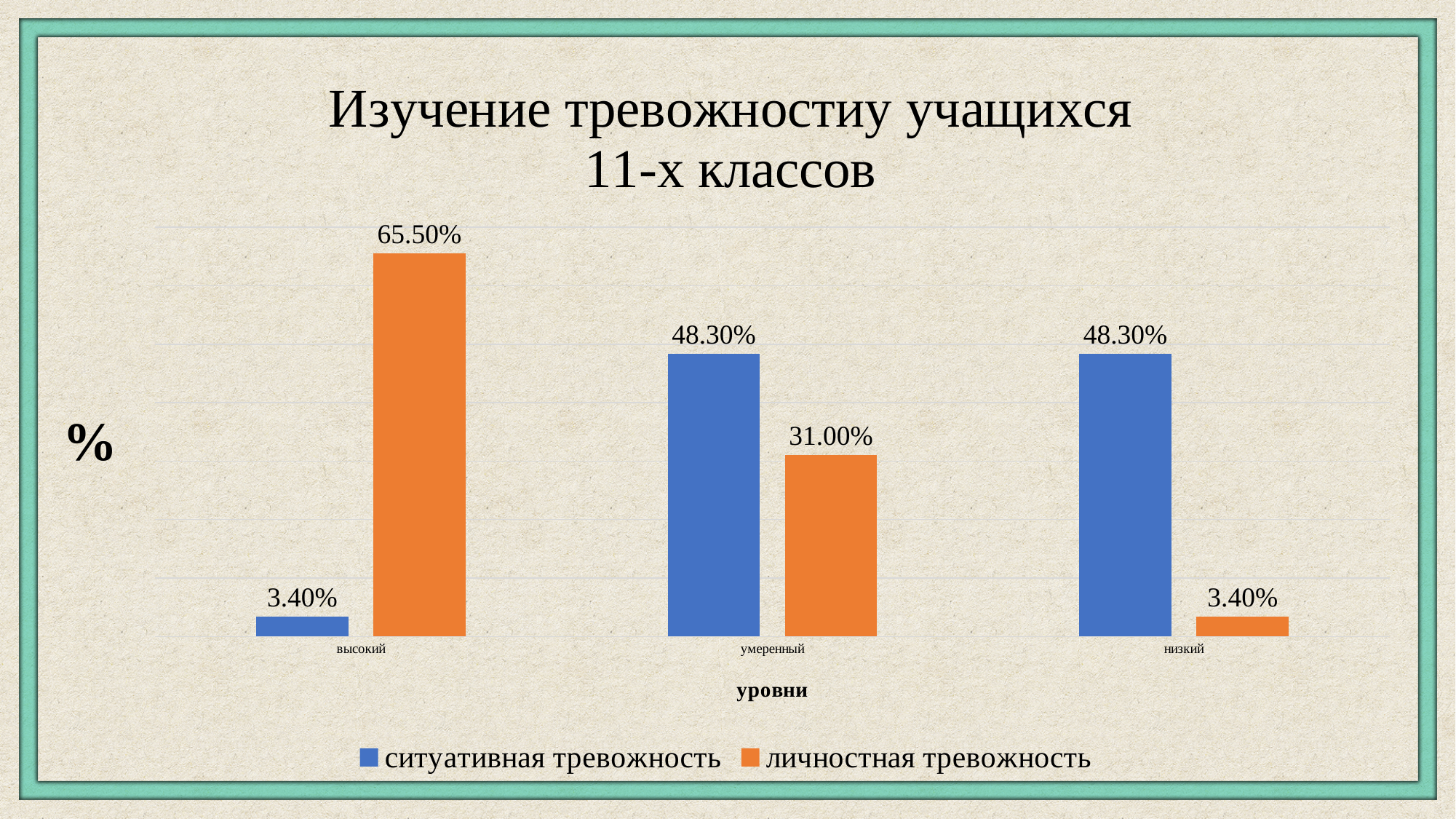
What is the value for ситуативная тревожность at the высокий level? 3.40% What is the value for личностная тревожность at the умеренный level? 31.00% What kind of chart is shown on the slide? bar chart At the умеренный level, which is larger: ситуативная тревожность or личностная тревожность? ситуативная тревожность What is the difference between личностная тревожность and ситуативная тревожность at the высокий level? 62.10% At which level is личностная тревожность lowest? низкий How many levels (categories) are shown on the x axis? 3 What is the value for личностная тревожность at the высокий level? 65.50% What is the value for ситуативная тревожность at the низкий level? 48.30% What is the difference between ситуативная тревожность and личностная тревожность at the умеренный level? 17.30% How many series does the legend list? 2 At which level is личностная тревожность highest? высокий